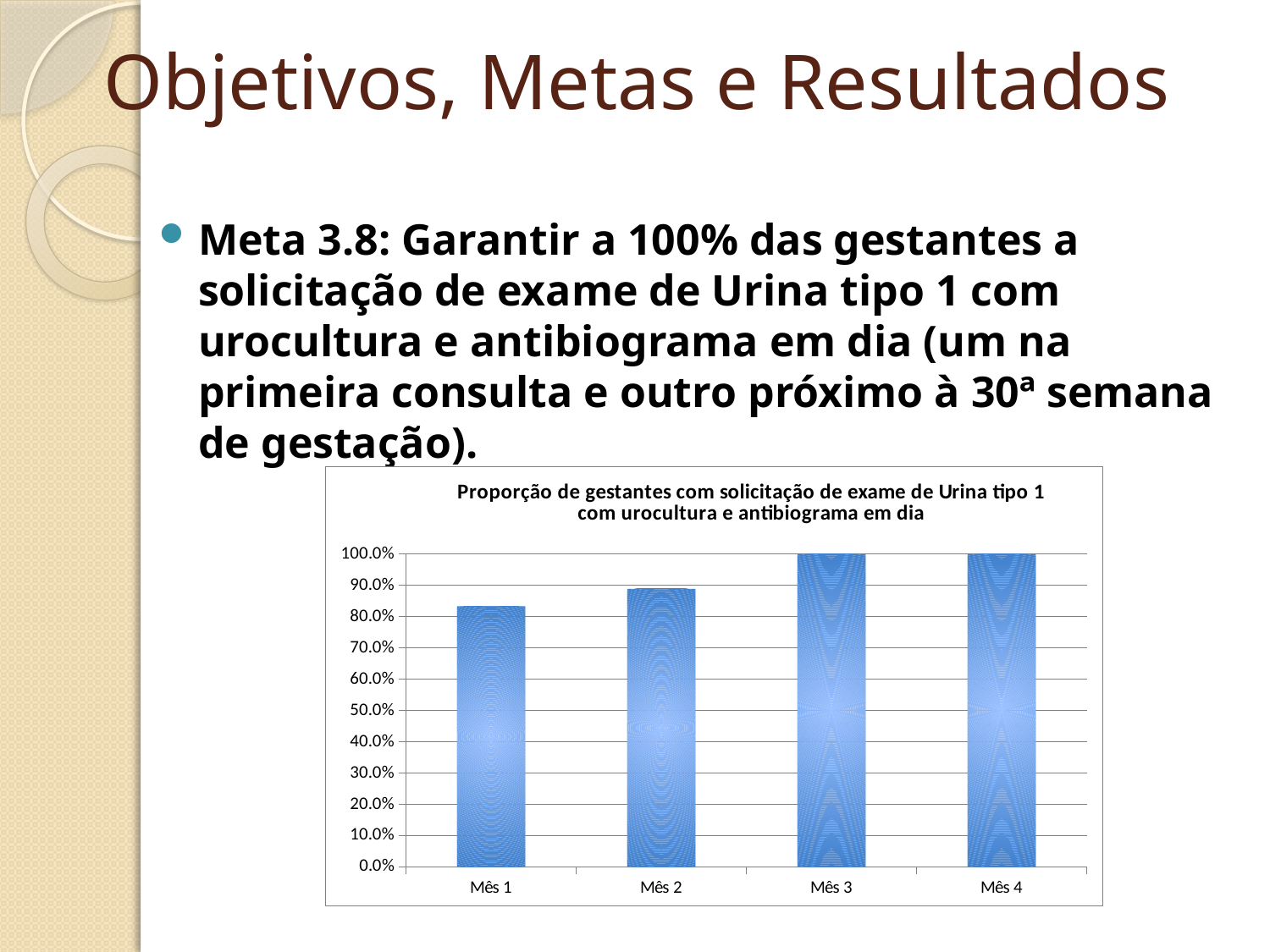
What kind of chart is shown on the slide? bar chart What is the value for Mês 3 in the chart? 100.0% Is the value for Mês 1 greater or less than 90.0%? less Which months reach the highest value (100.0%) in the chart? Mês 3 and Mês 4 Do the values rise or fall from Mês 1 to Mês 4? rise What is the value for Mês 4 in the chart? 100.0% What is the title of the chart? Proporção de gestantes com solicitação de exame de Urina tipo 1 com urocultura e antibiograma em dia How many months (categories) are plotted on the x axis of the chart? 4 Which month has the lowest value in the chart? Mês 1 Is the value for Mês 2 greater or less than 80.0%? greater Which is larger, the value for Mês 1 or the value for Mês 2? Mês 2 Is the value for Mês 1 greater or less than 80.0%? greater